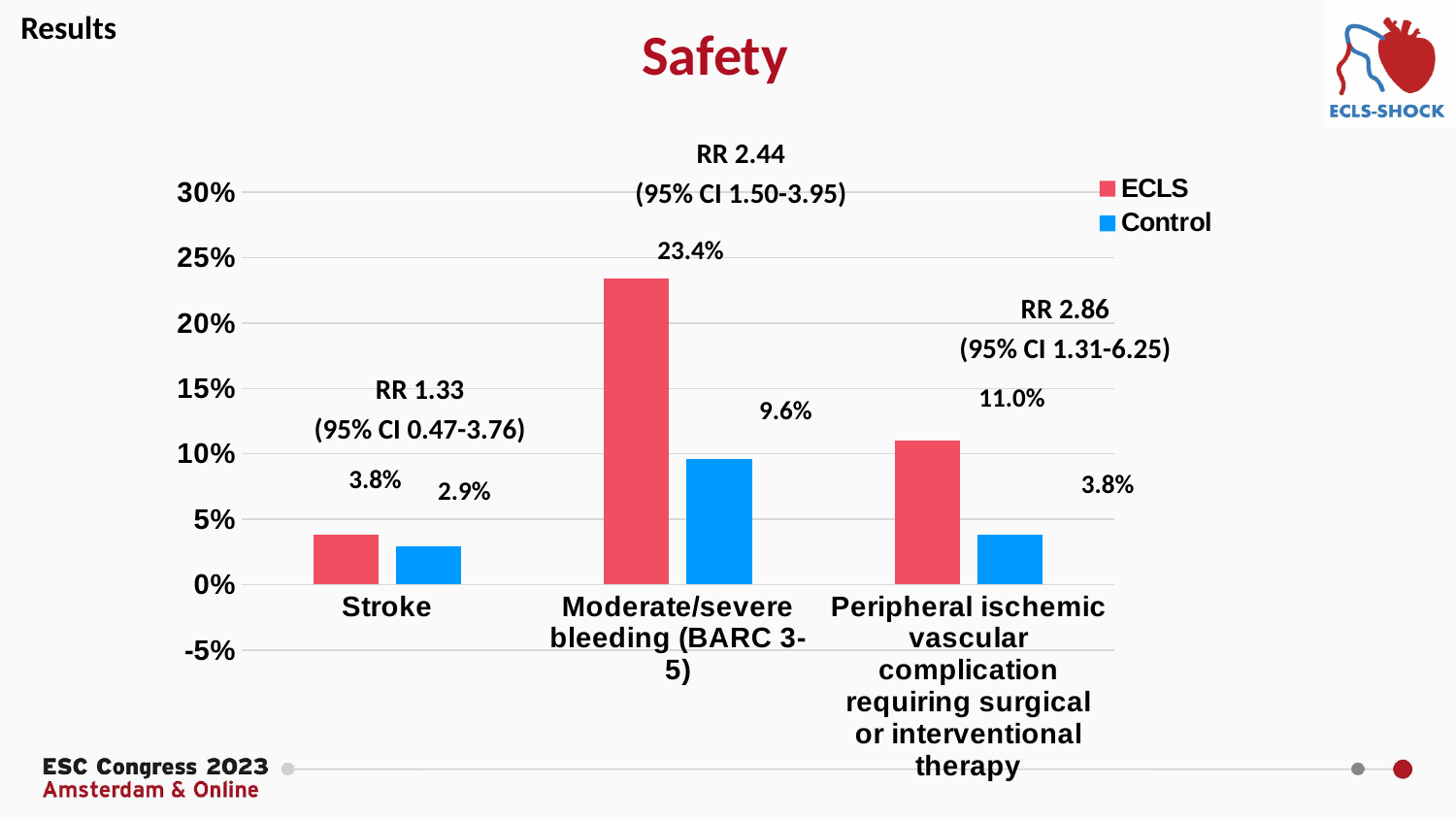
What is the difference between the ECLS and Control values for Moderate/severe bleeding (BARC 3-5)? 13.8% Which category has the highest ECLS value? Moderate/severe bleeding (BARC 3-5) How many categories are shown on the x axis? 3 What is the Control value for Stroke? 2.9% What kind of chart is shown on the slide? Bar chart What is the Control value for Moderate/severe bleeding (BARC 3-5)? 9.6% What is the ECLS value for Moderate/severe bleeding (BARC 3-5)? 23.4% What is the ECLS value for Peripheral ischemic vascular complication requiring surgical or interventional therapy? 11.0% How many series does the legend list? 2 Which category has the lowest Control value? Stroke What is the title of the chart? Safety Which is larger for Peripheral ischemic vascular complication: the ECLS value or the Control value? ECLS